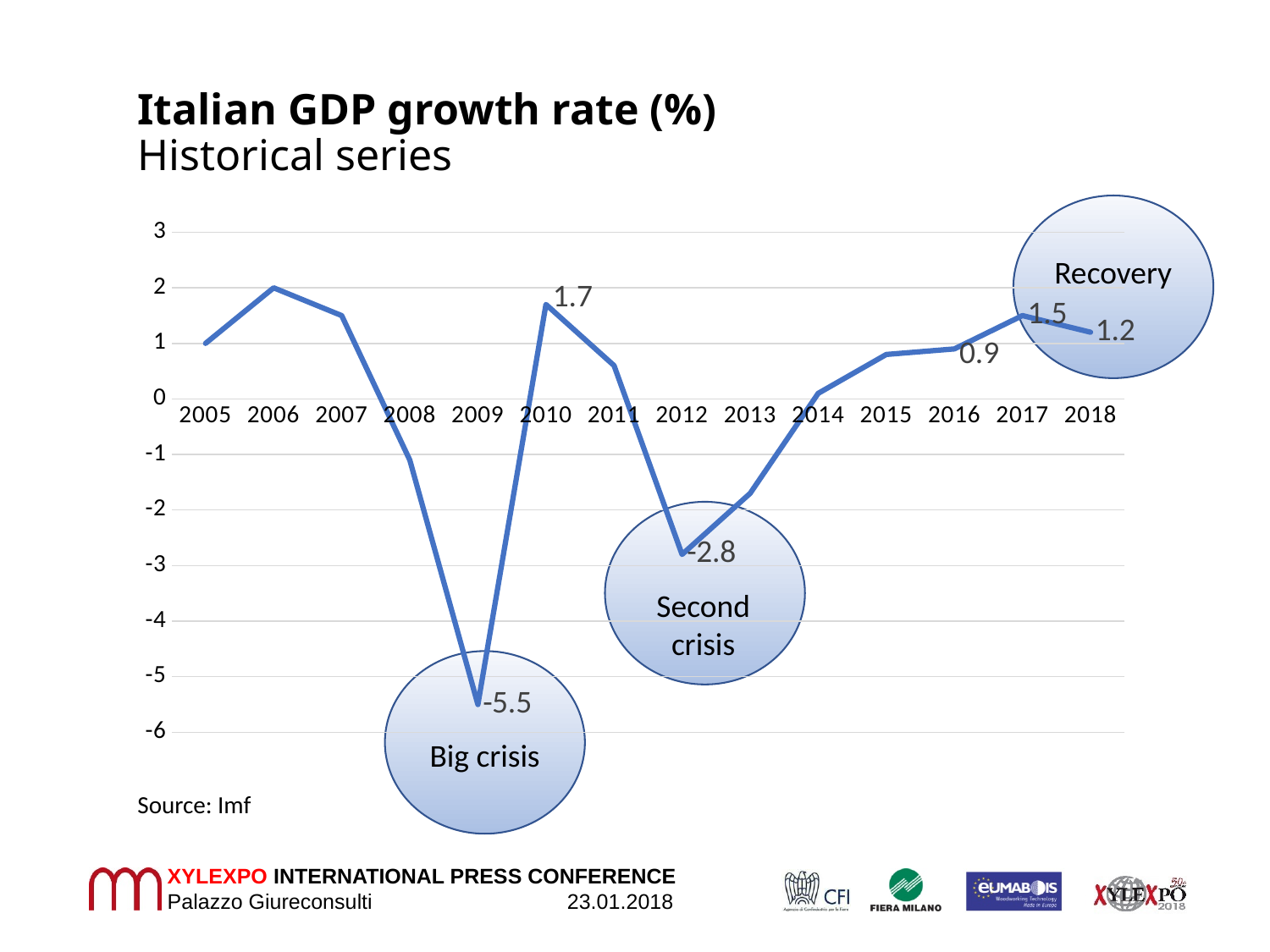
What is the GDP growth rate shown for 2018? 1.2 What value is labelled for 2010? 1.7 What is the Italian GDP growth rate shown for 2009? -5.5 Which year has the lowest GDP growth rate on the chart? 2009 What is the GDP growth rate shown for 2012? -2.8 What kind of chart is shown on the slide? line chart What source is cited for the chart data? Imf Is the value for 2008 greater or less than 0? less What is the difference between the values for 2017 and 2018? 0.3 Which year has the higher value, 2010 or 2017? 2010 How many years are shown on the x axis? 14 What value is labelled for 2016? 0.9